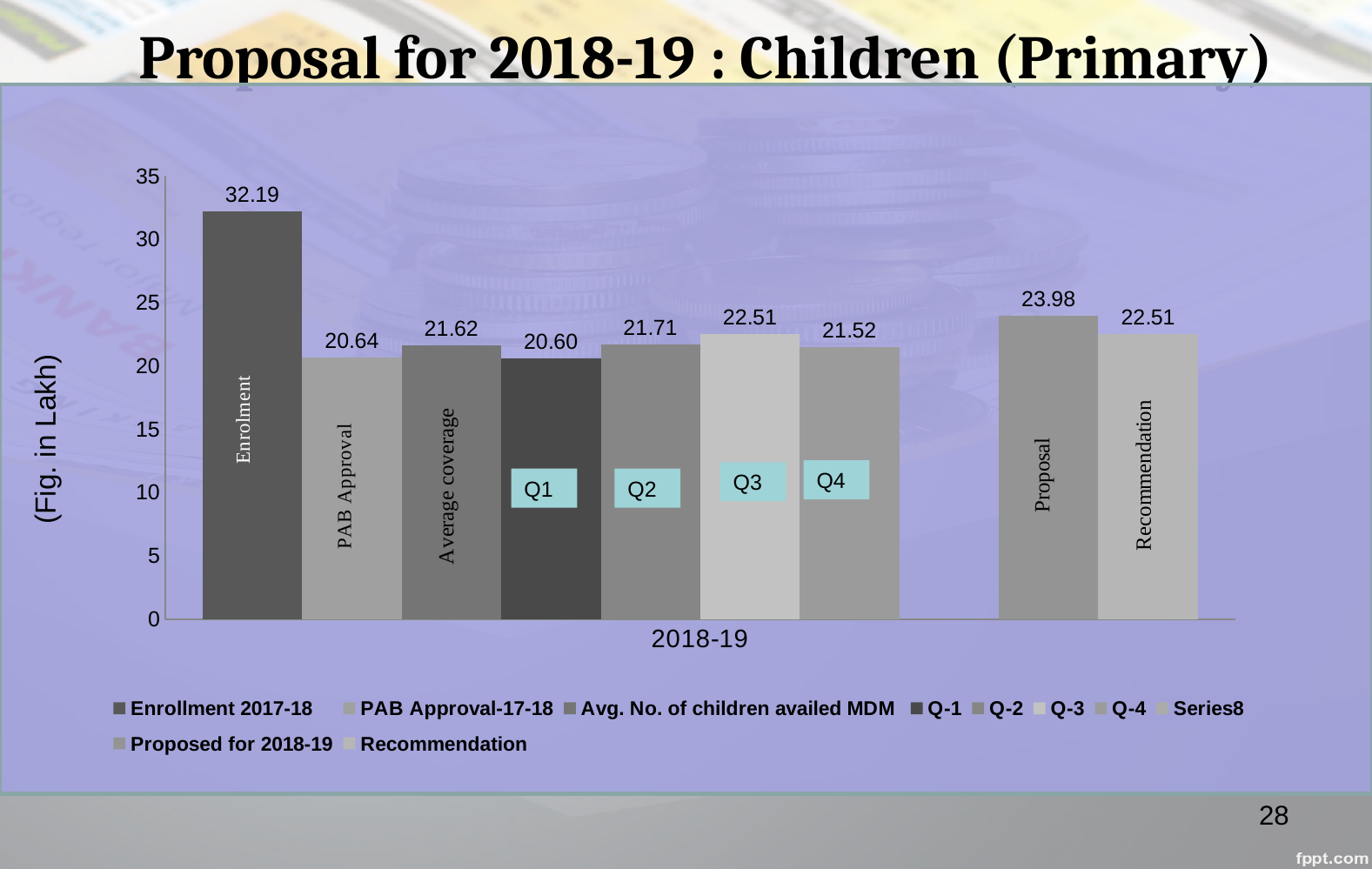
What is the unit stated on the vertical axis label? Fig. in Lakh What is the difference between the Proposal value and the Recommendation value? 1.47 What type of chart is shown on the slide? Bar chart What is the value shown for Q3? 22.51 Which is larger, the value for Q2 or the value for Q4? Q2 What is the difference between the Enrolment value and the PAB Approval value? 11.55 What is the value of the Enrolment bar? 32.19 Which bar has the highest value? Enrolment Which bar has the lowest value? Q1 What is the value shown for PAB Approval? 20.64 What is the x-axis category label shown below the bars? 2018-19 What is the value of the Proposal bar? 23.98